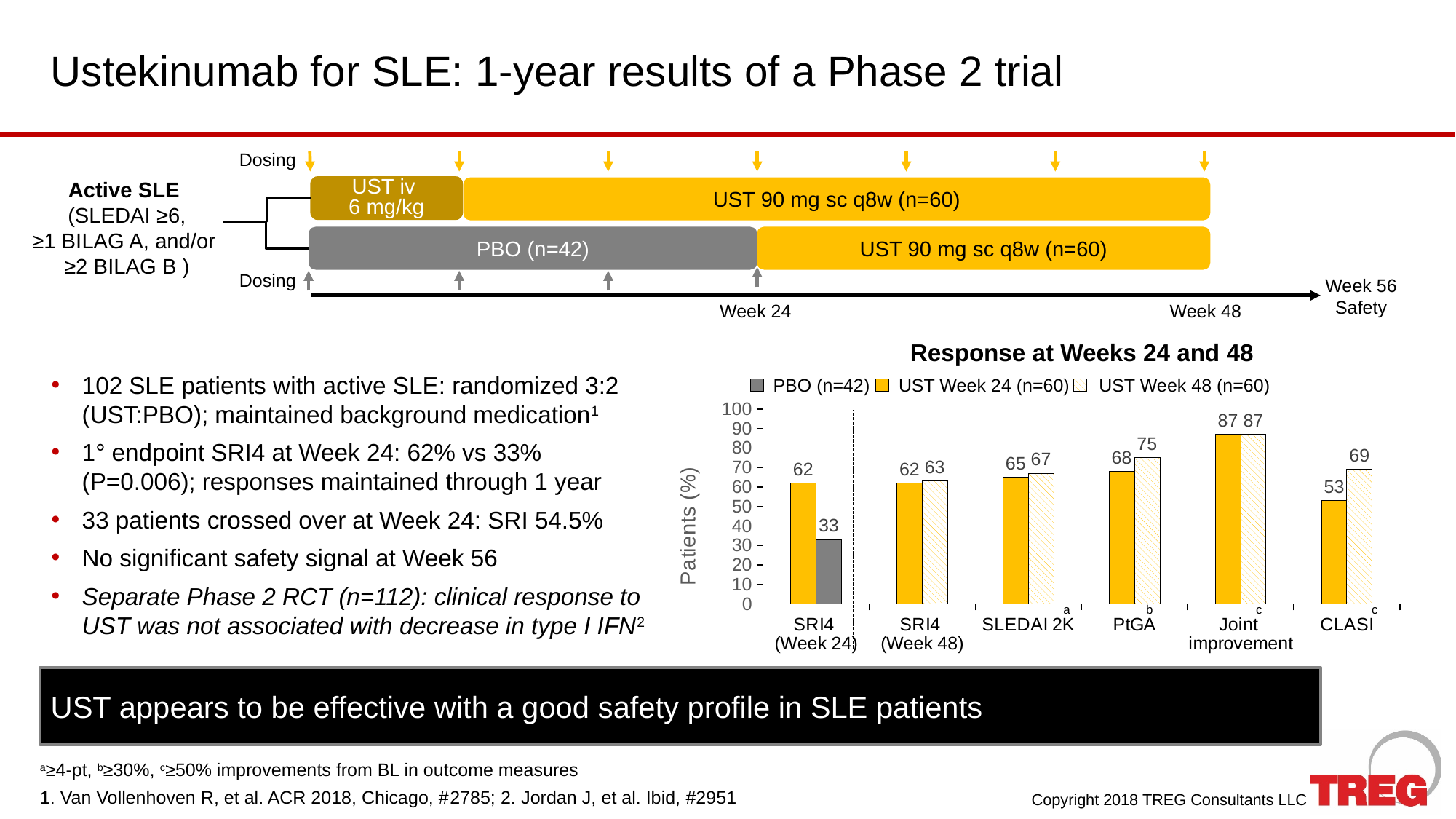
How many series does the legend of the 'Response at Weeks 24 and 48' chart list? 3 In the 'Response at Weeks 24 and 48' chart, which category has the lowest UST Week 24 (n=60) value? CLASI In the 'Response at Weeks 24 and 48' chart, what is the UST Week 48 (n=60) value for CLASI? 69 In the 'Response at Weeks 24 and 48' chart, what is the value for PBO (n=42) for SRI4 (Week 24)? 33 What type of chart is shown under the title 'Response at Weeks 24 and 48'? Bar chart In the 'Response at Weeks 24 and 48' chart, which is larger for PtGA: the UST Week 24 value or the UST Week 48 value? UST Week 48 In the 'Response at Weeks 24 and 48' chart, what is the difference between the UST Week 48 and UST Week 24 values for CLASI? 16 How many categories are shown on the x axis of the 'Response at Weeks 24 and 48' chart? 6 What is the y-axis label of the 'Response at Weeks 24 and 48' chart? Patients (%) In the 'Response at Weeks 24 and 48' chart, what is the UST Week 24 (n=60) value for PtGA? 68 In the 'Response at Weeks 24 and 48' chart, what is the difference between the UST Week 24 and PBO values for SRI4 (Week 24)? 29 In the 'Response at Weeks 24 and 48' chart, which category has the highest UST Week 48 (n=60) value? Joint improvement